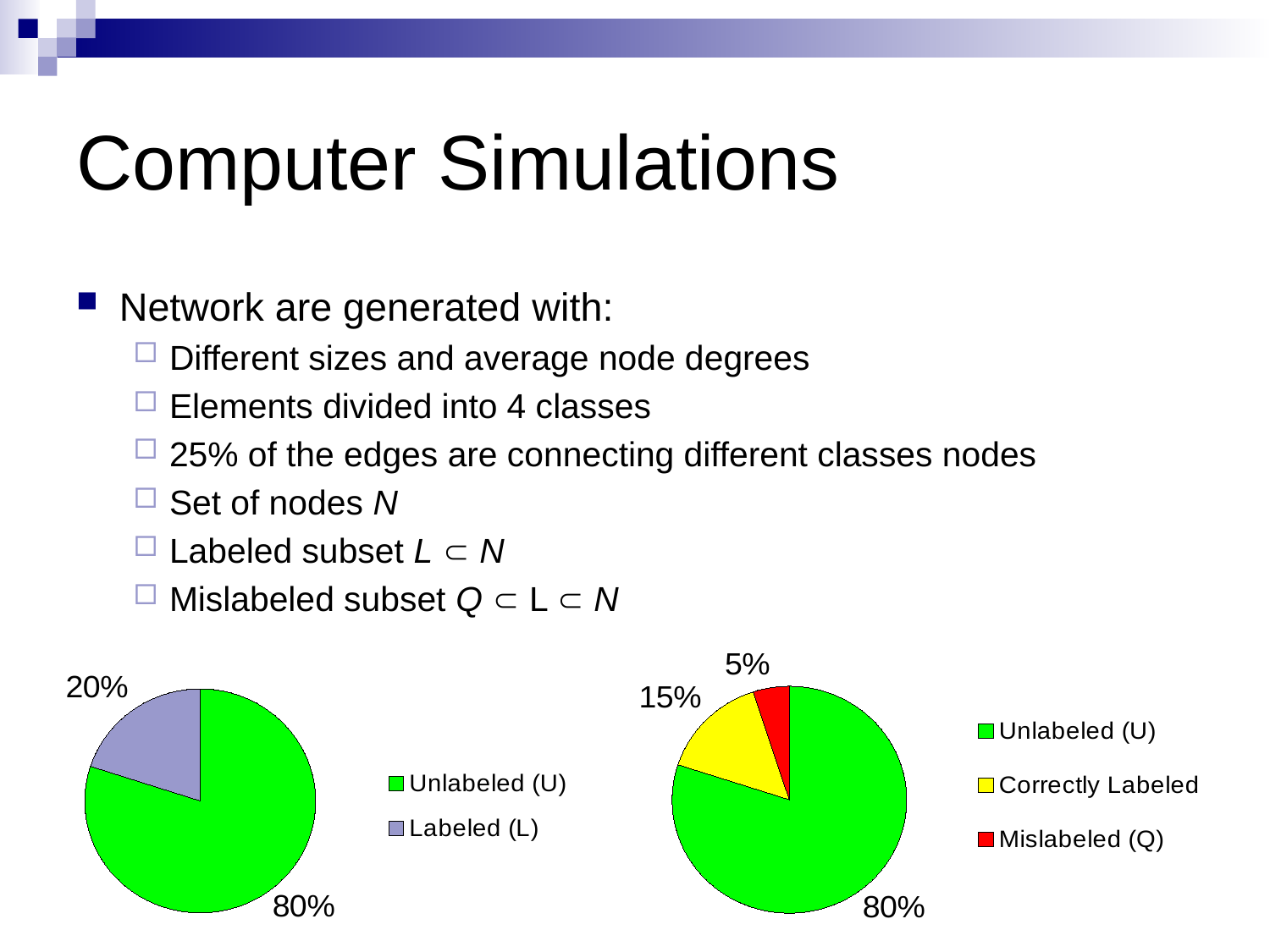
How many slices does the right pie chart have? 3 In the right pie chart, which category has the largest slice? Unlabeled (U) In the right pie chart, which category has the smallest slice? Mislabeled (Q) In the left pie chart, what share is Labeled (L)? 20% What type of chart is shown on the left of the slide? Pie chart How many entries does the legend of the left pie chart list? 2 In the right pie chart, what share is Mislabeled (Q)? 5% In the right pie chart, which is larger: Correctly Labeled or Mislabeled (Q)? Correctly Labeled In the left pie chart, what is the difference between the Unlabeled (U) and Labeled (L) shares? 60% In the left pie chart, what share is Unlabeled (U)? 80% In the right pie chart, what share is Correctly Labeled? 15% In the right pie chart, what colour is the Mislabeled (Q) slice? Red